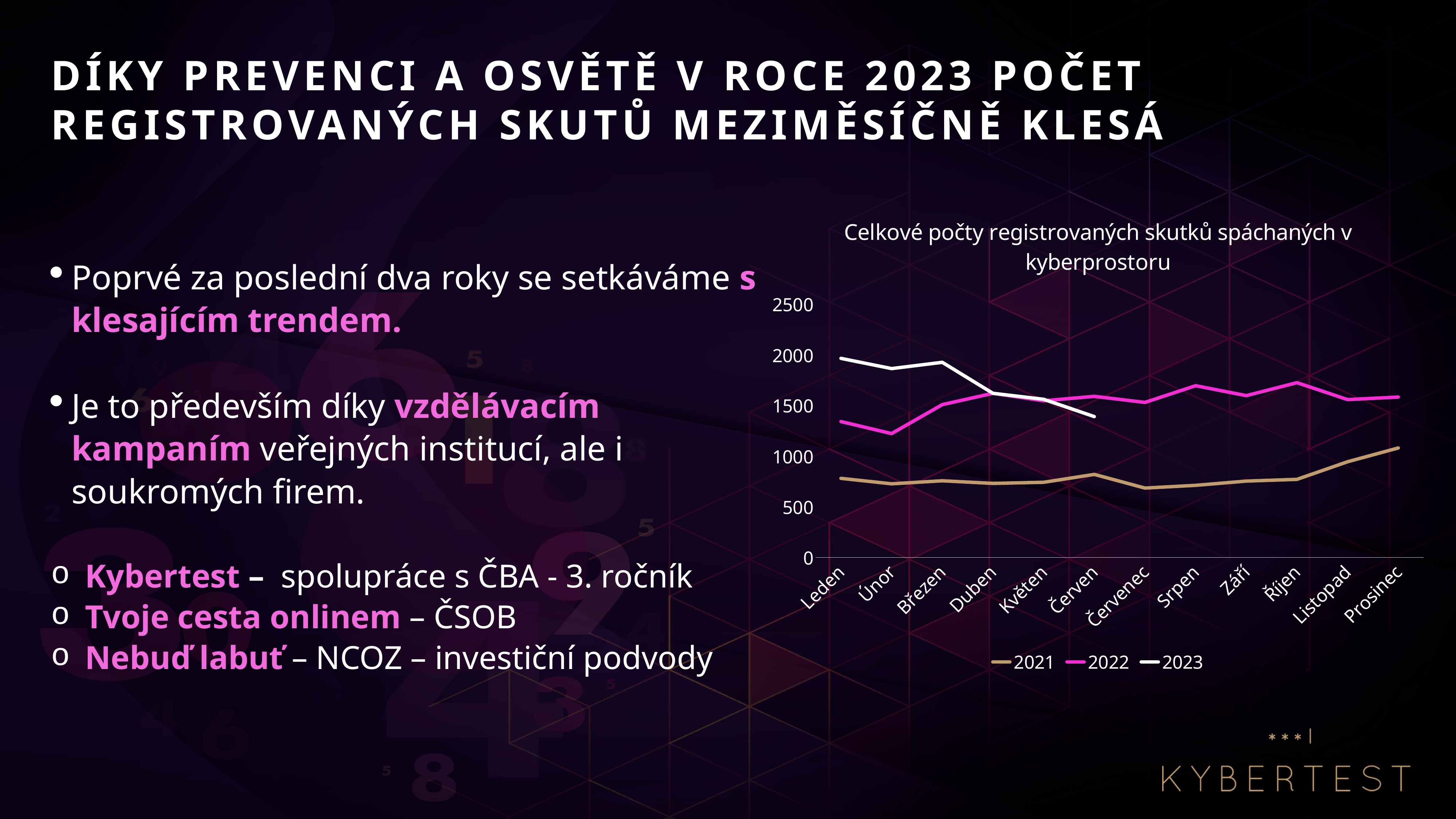
How many series does the legend of the chart list? 3 What kind of chart is shown on the slide? line chart Does the 2023 line rise or fall from Leden to Červen? fall In Leden, which series has the larger value, 2022 or 2023? 2023 Is the value for 2022 in Únor greater or less than 1500? less In which month does the 2021 series reach its highest value? Prosinec Is the value for 2023 in Červen greater or less than 1500? less Is the value for 2021 in Leden greater or less than 1000? less Which series is drawn in white on the chart? 2023 How many months are shown on the x axis of the chart? 12 What is the title of the chart? Celkové počty registrovaných skutků spáchaných v kyberprostoru